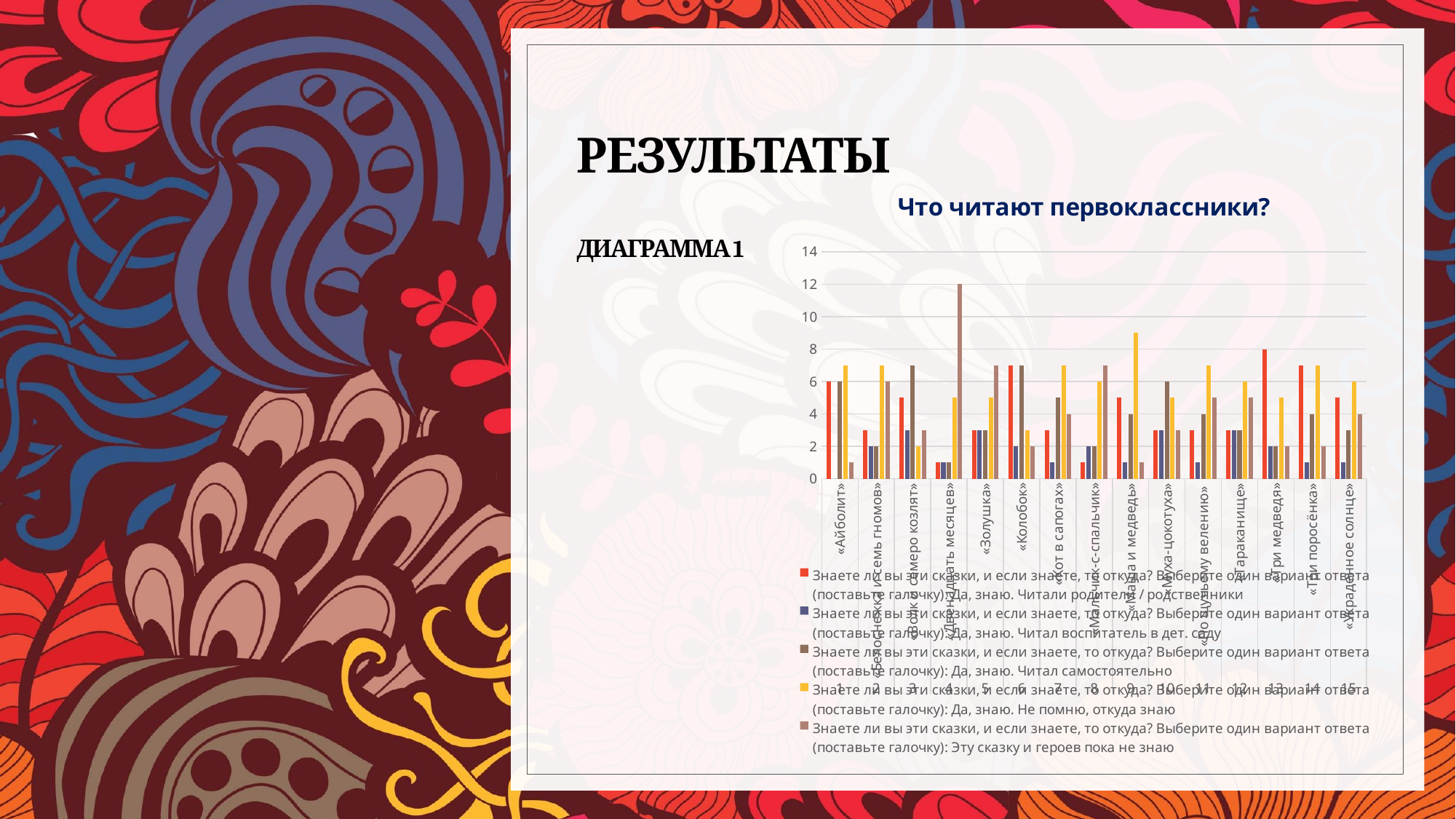
What is the title of the chart? Что читают первоклассники? Is the value of the 'Да, знаю. Читали родители / родственники' series for «Три медведя» greater or less than 6? greater For the 'Да, знаю. Читали родители / родственники' series, which is larger: «Колобок» or «Белоснежка и семь гномов»? «Колобок» What is the highest value shown on the chart's vertical axis? 14 Is the value of the 'Да, знаю. Читали родители / родственники' series for «Двенадцать месяцев» greater or less than 2? less What kind of chart is shown on the slide? bar chart Is the value of the 'Да, знаю. Читали родители / родственники' series for «Айболит» greater or less than 4? greater How many series does the chart's legend list? 5 Which fairy tale has the tallest bar in the chart? «Двенадцать месяцев» How many fairy-tale categories are shown along the x axis of the chart? 15